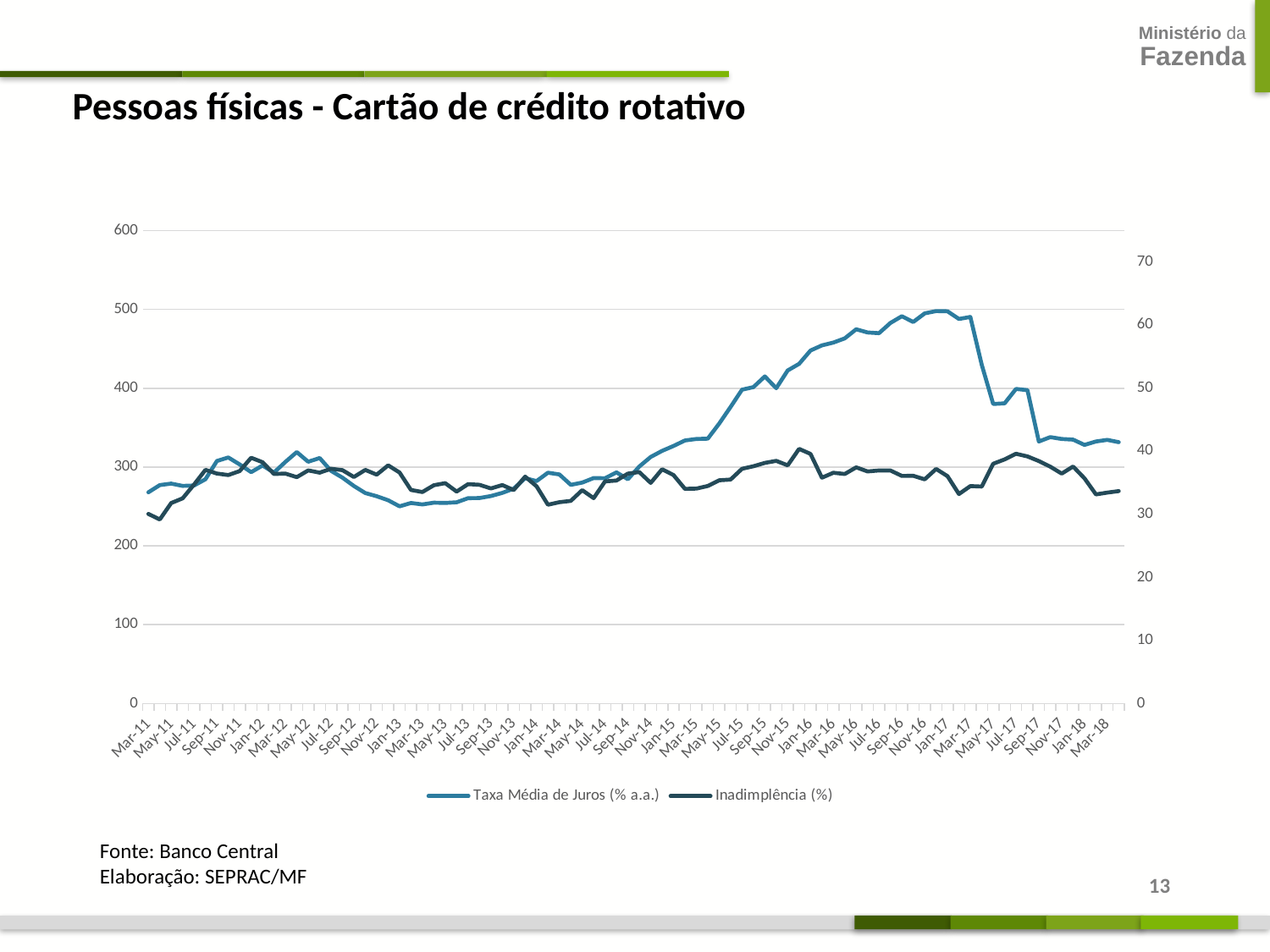
Which is larger for Taxa Média de Juros (% a.a.): the value in Jan-17 or the value in Mar-18? Jan-17 Is the value of Inadimplência (%) in Jan-16 greater or less than 30 on the right axis? greater Is the value of Taxa Média de Juros (% a.a.) in Mar-11 greater or less than 300? less Does the Taxa Média de Juros (% a.a.) series generally rise or fall between Jan-15 and Jan-17? rise Which two series are listed in the chart legend? Taxa Média de Juros (% a.a.) and Inadimplência (%) What kind of chart is shown on the slide? line chart What is the title of the chart on the slide? Pessoas físicas - Cartão de crédito rotativo Does the Taxa Média de Juros (% a.a.) series generally rise or fall between Jan-17 and Mar-18? fall Is the value of Inadimplência (%) in Jan-16 greater or less than 50 on the right axis? less How many series does the legend list? 2